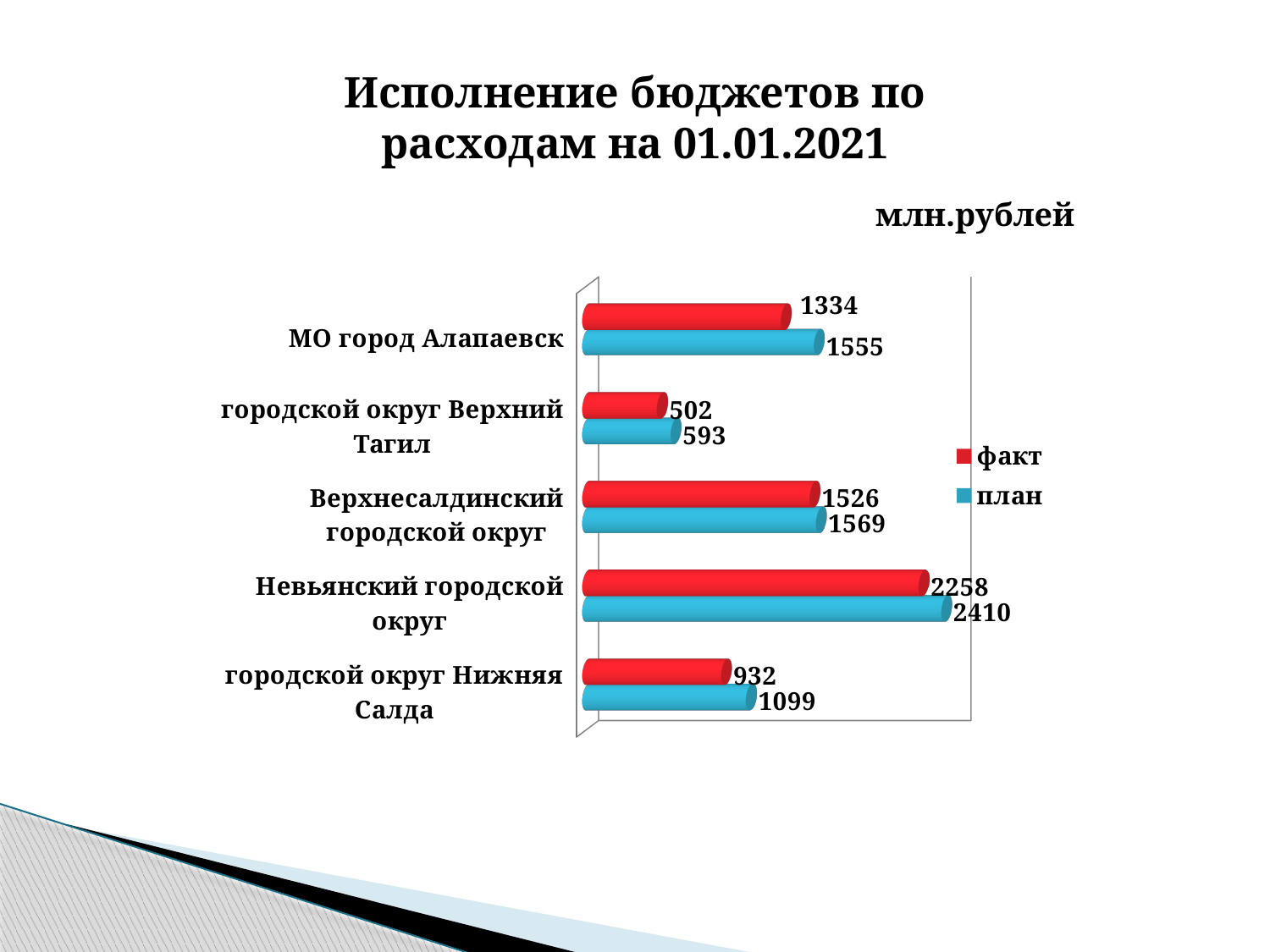
What kind of chart is shown on the slide? bar chart Which category has the lowest факт value? городской округ Верхний Тагил What is the план value for городской округ Верхний Тагил? 593 What is the факт value for МО город Алапаевск? 1334 Which is larger: the факт value for Верхнесалдинский городской округ or the факт value for МО город Алапаевск? Верхнесалдинский городской округ What is the difference between план and факт for МО город Алапаевск? 221 How many categories are shown on the chart? 5 How many series does the legend list? 2 What is the difference between план and факт for Верхнесалдинский городской округ? 43 What is the план value for Невьянский городской округ? 2410 Which category has the highest план value? Невьянский городской округ What is the факт value for городской округ Нижняя Салда? 932